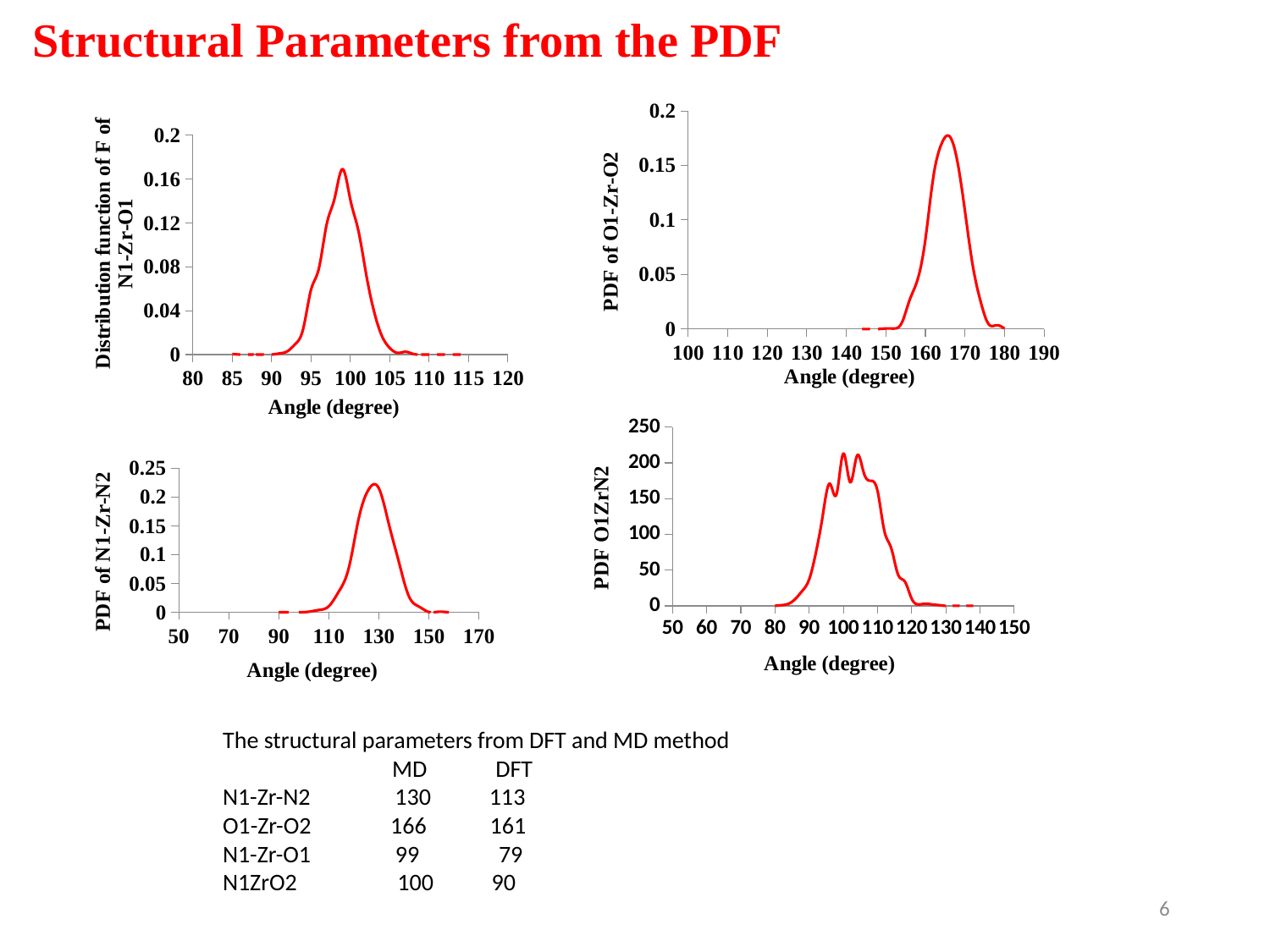
In the bottom-right chart (PDF O1ZrN2), is the peak value of the curve greater or less than 150? greater In the top-right chart (PDF of O1-Zr-O2), is the peak value of the curve greater or less than 0.15? greater What is the x-axis label of the bottom-right chart (PDF O1ZrN2)? Angle (degree) What is the highest tick value shown on the y axis of the bottom-right chart (PDF O1ZrN2)? 250 In the top-left chart (N1-Zr-O1), is the peak value of the curve greater or less than 0.12? greater In the top-right chart (PDF of O1-Zr-O2), does the curve rise or fall between 150 and 165 degrees on the x axis? rise How many charts are shown on the slide? 4 In the top-left chart (N1-Zr-O1), does the curve rise or fall between 100 and 105 degrees on the x axis? fall What kind of chart is the top-left chart titled 'Distribution function of F of N1-Zr-O1'? line chart